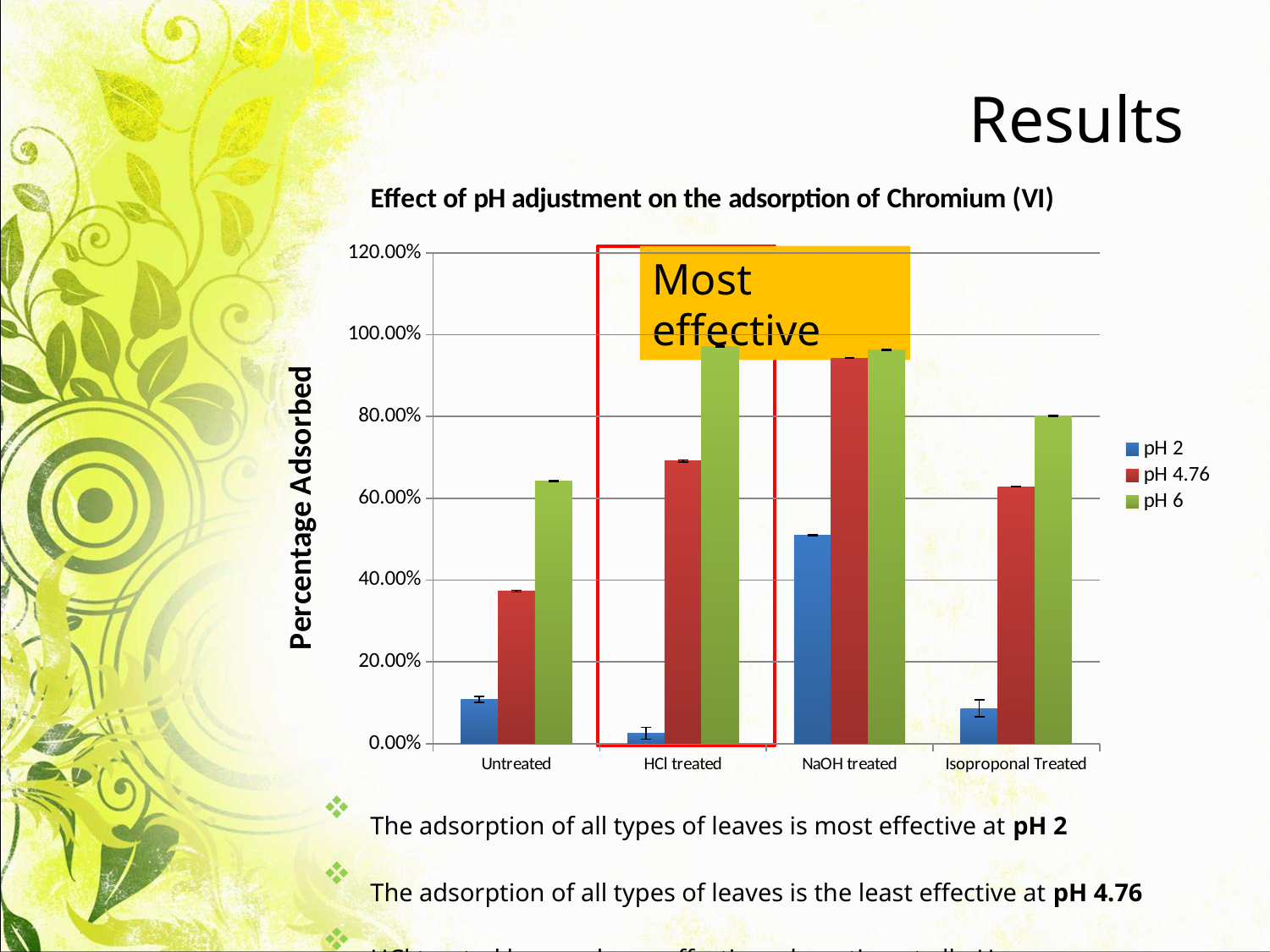
How many treatment categories are shown on the x axis? 4 Is the pH 2 value for NaOH treated greater or less than 40.00%? greater Is the pH 4.76 value for NaOH treated greater or less than 80.00%? greater How many series does the legend list? 3 Which is larger: the pH 6 value for Untreated or the pH 6 value for Isoproponal Treated? Isoproponal Treated Is the pH 6 value for HCl treated greater or less than 80.00%? greater What type of chart is shown on the slide? bar chart Which treatment category has the lowest pH 2 value? HCl treated For the Untreated category, which pH series has the highest value? pH 6 What is the label on the vertical axis? Percentage Adsorbed What is the title of the chart? Effect of pH adjustment on the adsorption of Chromium (VI)